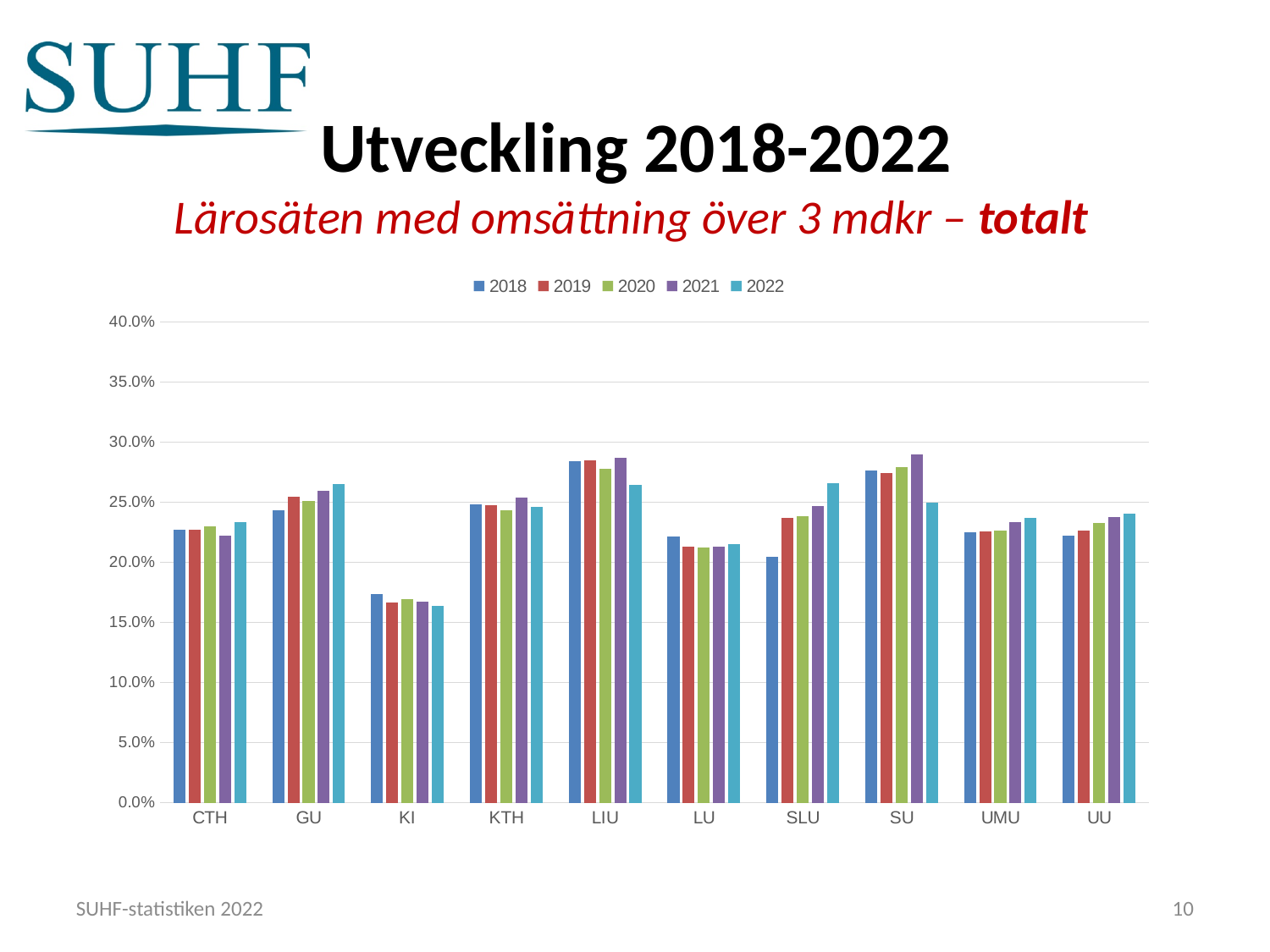
For SLU, which year has the larger value, 2018 or 2022? 2022 How many institutions (categories) are shown on the x axis? 10 What kind of chart is shown on the slide? Bar chart Do the values for UU rise or fall from 2018 to 2022? Rise Is the 2019 value for LU greater or less than 25.0%? less Is the 2018 value for LIU greater or less than 25.0%? greater Is the 2018 value for KI greater or less than 20.0%? less What is the main title of the slide above the chart? Utveckling 2018-2022 How many series does the legend list? 5 For SU, which year has the larger value, 2021 or 2022? 2021 Which institution has the lowest values across all years? KI